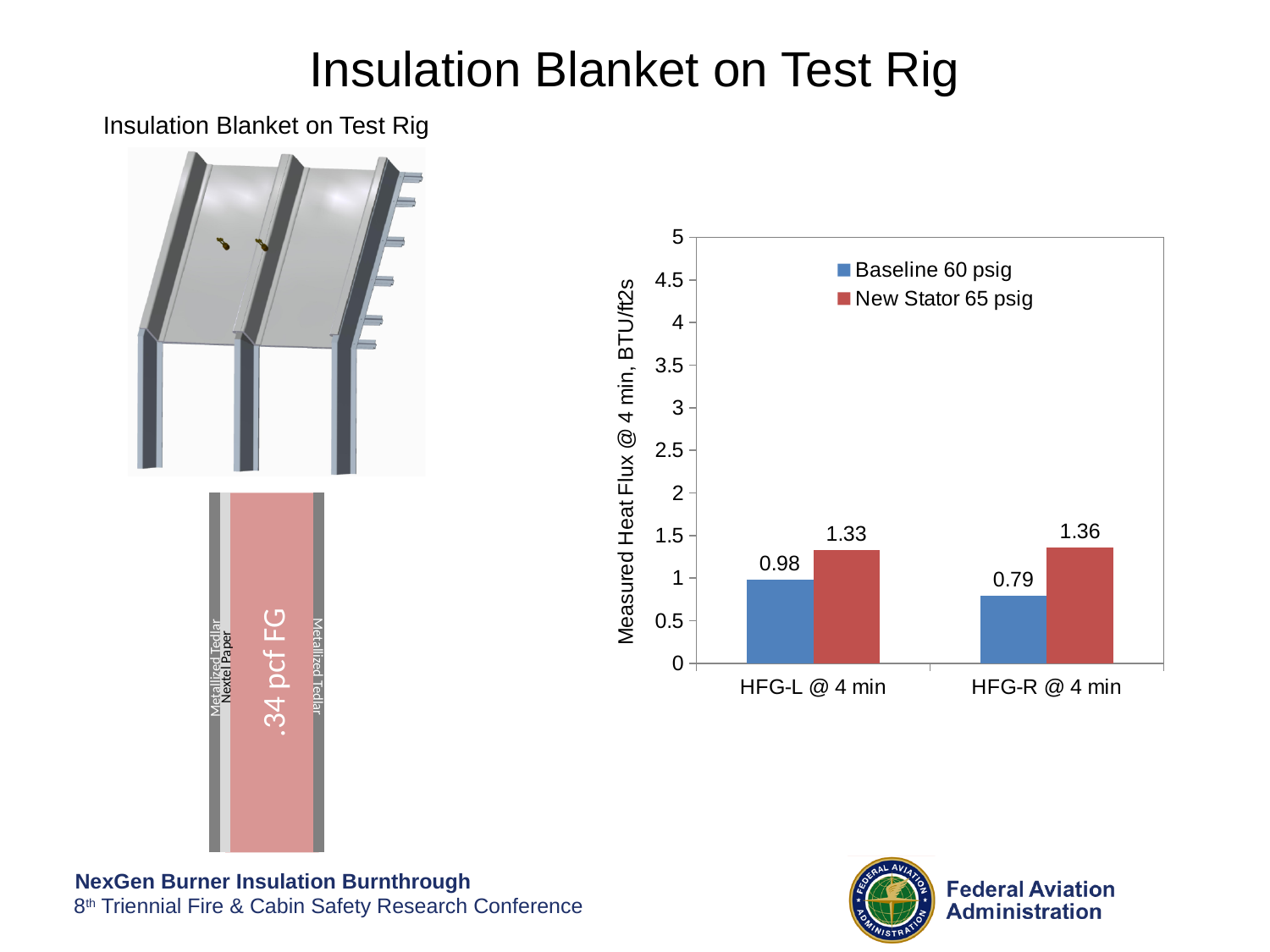
Which is larger for HFG-L @ 4 min: the Baseline 60 psig value or the New Stator 65 psig value? New Stator 65 psig What is the New Stator 65 psig value for HFG-L @ 4 min? 1.33 Is the Baseline 60 psig value for HFG-R @ 4 min greater or less than 1? less How many series does the chart legend list? 2 What is the difference between the New Stator 65 psig and Baseline 60 psig values for HFG-R @ 4 min? 0.57 What is the Baseline 60 psig value for HFG-L @ 4 min? 0.98 What is the New Stator 65 psig value for HFG-R @ 4 min? 1.36 How many categories are shown on the x axis of the chart? 2 What kind of chart is shown on the slide? bar chart What is the difference between the New Stator 65 psig and Baseline 60 psig values for HFG-L @ 4 min? 0.35 Which category has the lowest Baseline 60 psig value? HFG-R @ 4 min What is the Baseline 60 psig value for HFG-R @ 4 min? 0.79